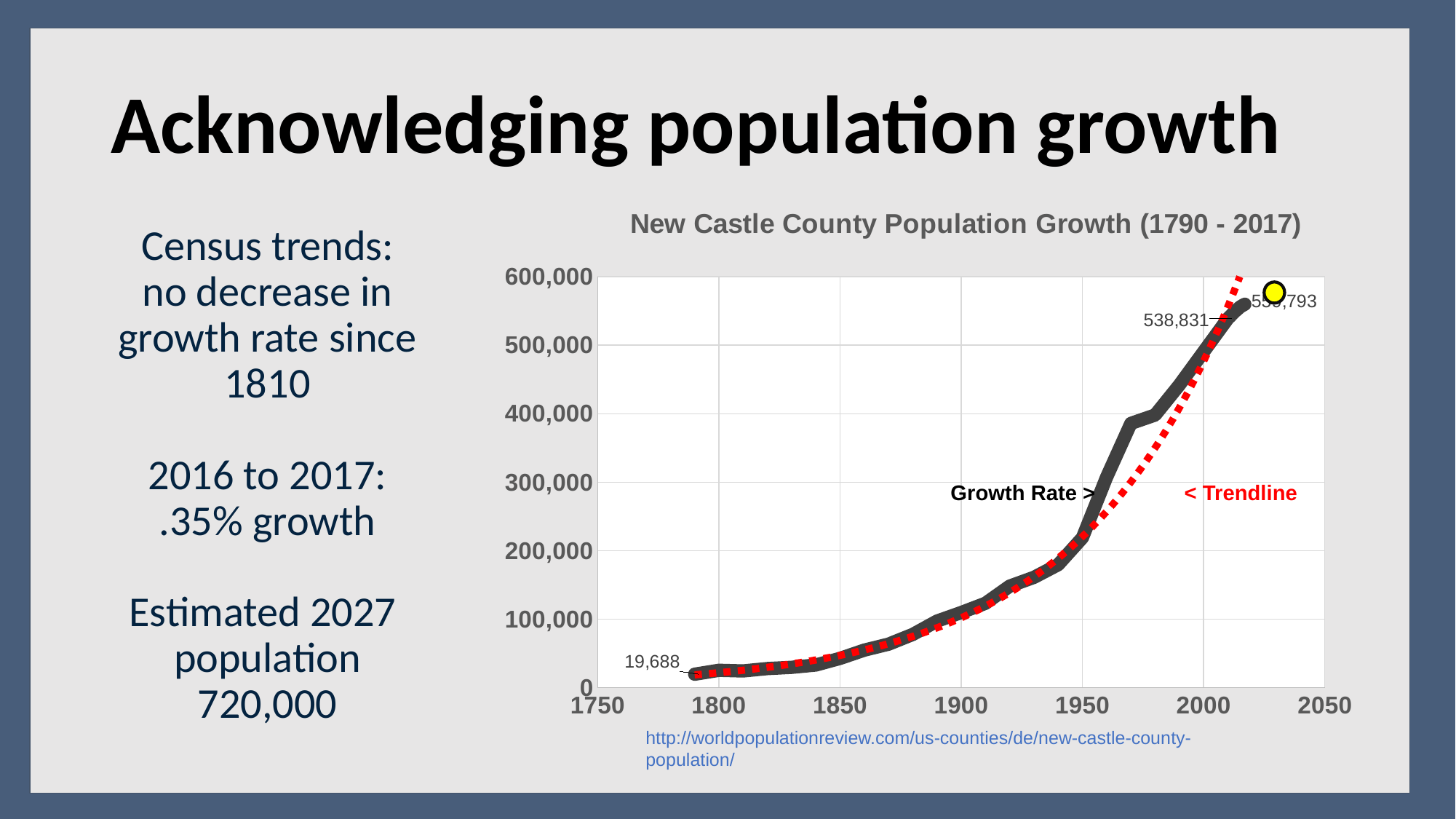
What kind of chart is shown on the slide? line chart What population value is labelled at the start of the series in 1790? 19,688 What is the difference between the labelled value 538,831 and the labelled value 19,688? 519,143 What colour is the dotted trendline on the chart? red What is the title of the chart? New Castle County Population Growth (1790 - 2017) Is the population value for 1950 greater or less than 200,000? greater Is the population value for 1850 greater or less than 100,000? less Is the population value at the end of the series (2017) greater or less than 500,000? greater What population value is labelled on the line near 2010? 538,831 Does the population rise or fall from 1790 to 2017? rise Which is larger, the labelled population in 1790 or the labelled population near 2010? near 2010 (538,831)